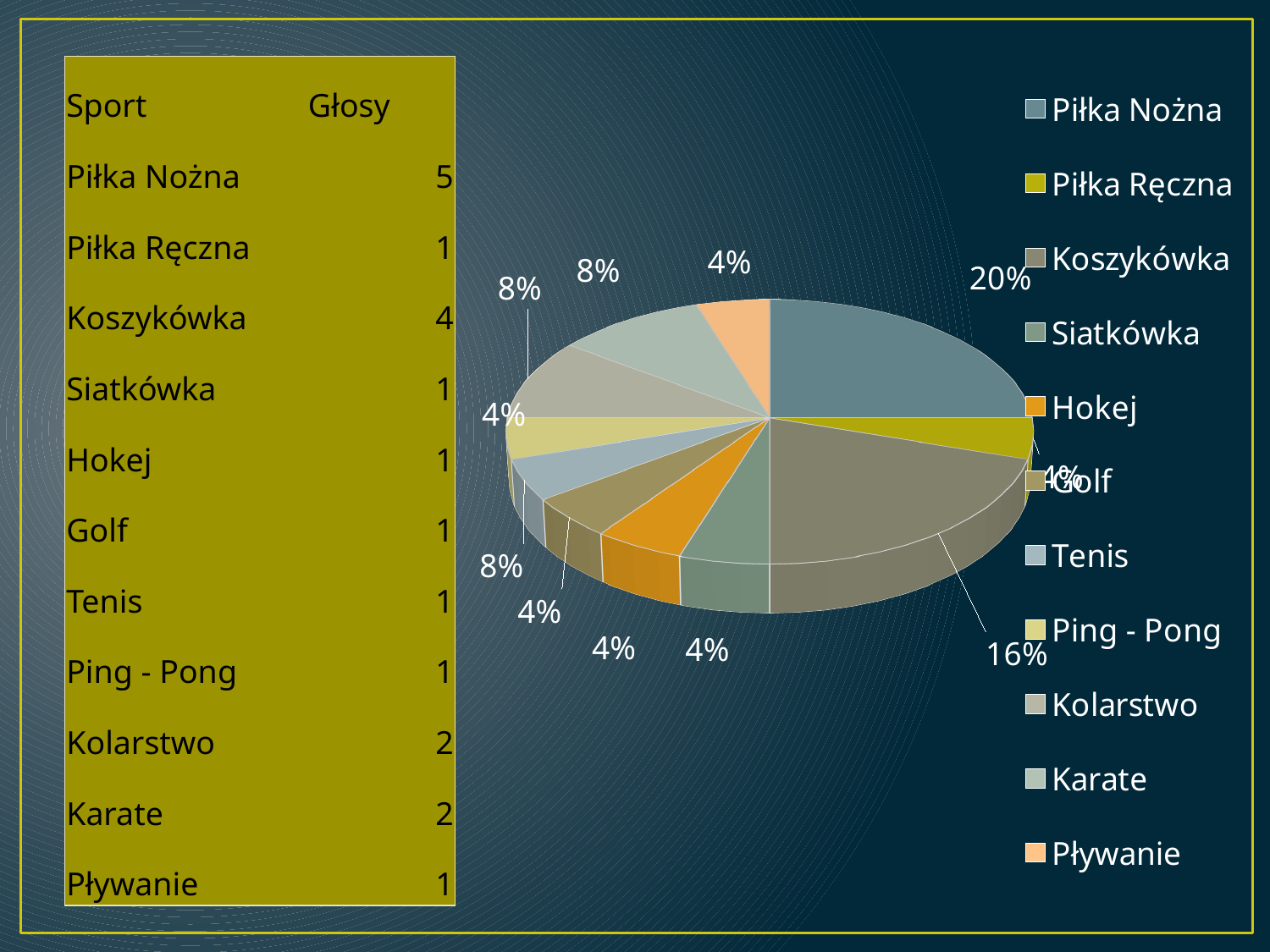
How many categories does the pie chart's legend list? 11 What kind of chart is shown on the slide? pie chart What share of the pie does Piłka Nożna have? 20% What share of the pie does Kolarstwo have? 8% Which legend entry is listed last in the pie chart's legend? Pływanie Which slice is larger, Karate or Hokej? Karate Which legend entry is shown in orange? Hokej Which slice is larger, Koszykówka or Kolarstwo? Koszykówka What share of the pie does Pływanie have? 4% What is the difference in percentage points between the Piłka Nożna slice and the Koszykówka slice? 4% Which category has the largest slice of the pie chart? Piłka Nożna